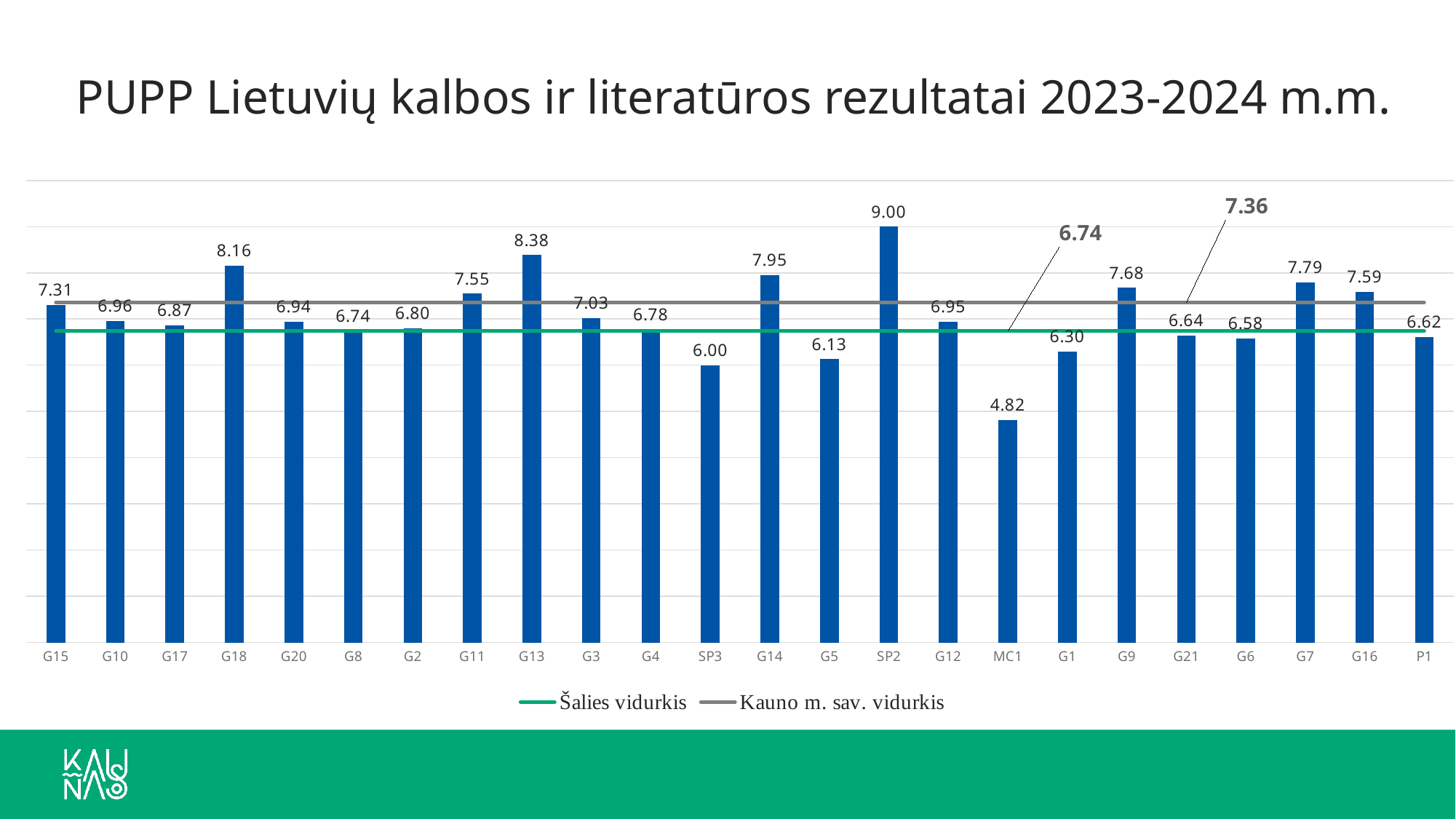
Which category has the lowest value? MC1 What is the difference between the values for G13 and G18? 0.22 What is the value for G9? 7.68 What is the value for SP2? 9.00 What kind of chart is shown on the slide? Bar chart Which is larger, the value for G18 or the value for G13? G13 What is the value for MC1? 4.82 What is the difference between the values for SP2 and MC1? 4.18 What value is labelled for the Kauno m. sav. vidurkis line? 7.36 How many entries does the legend list? 2 Which category has the highest value? SP2 How many categories are shown on the x axis? 24